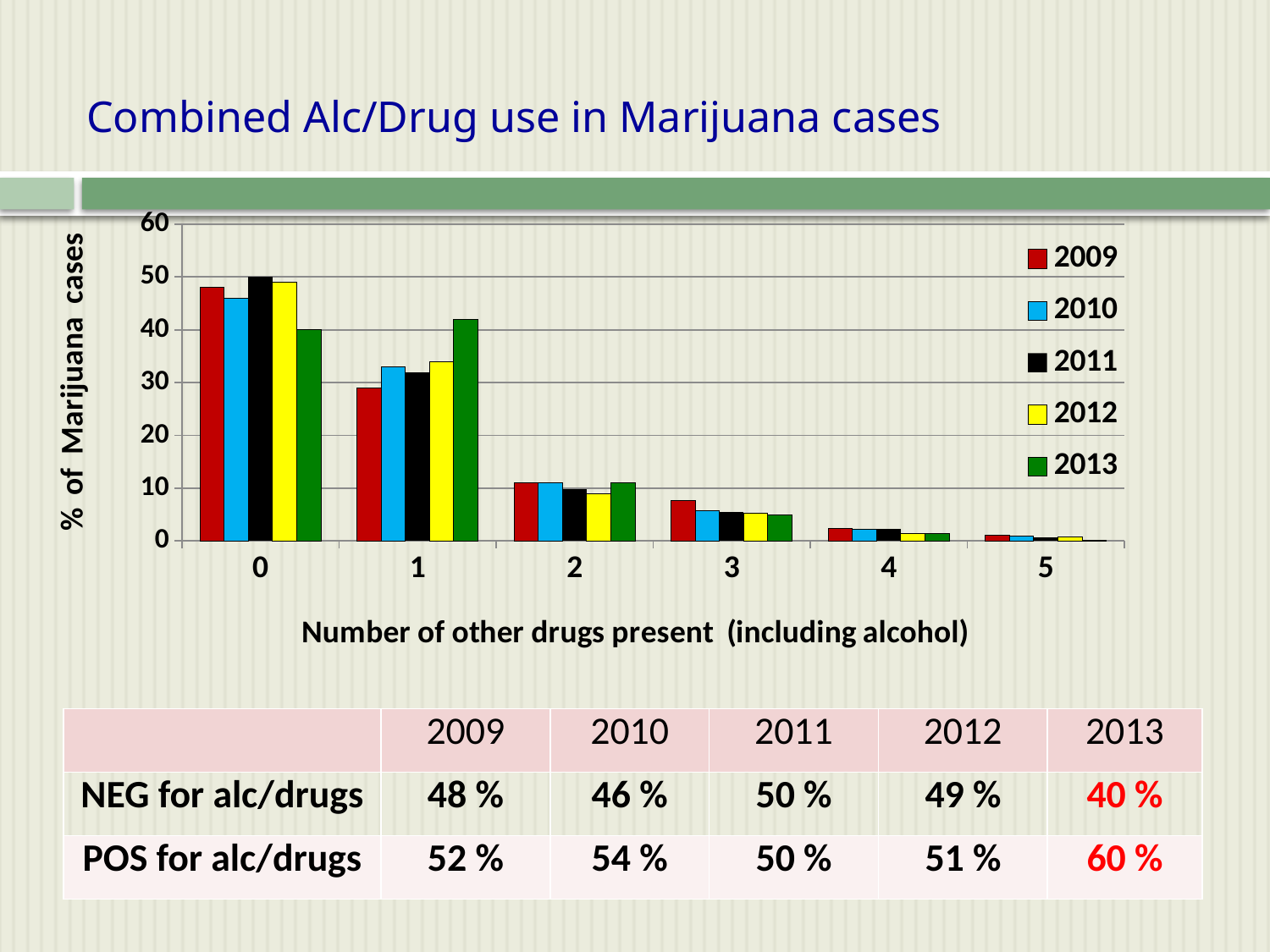
Is the value for 2011 at 4 other drugs present greater or less than 5? less What colour represents the 2013 series in the chart? green Which year has the highest bar for 1 other drug present? 2013 Which year has the lowest bar for 0 other drugs present? 2013 What kind of chart is shown on the slide? bar chart Is the value for 2010 at 1 other drug present greater or less than 30? greater How many series does the chart legend list? 5 Is the value for 2009 at 3 other drugs present greater or less than 10? less Do the values generally rise or fall as the number of other drugs present increases along the x axis? fall For 1 other drug present, which is larger: the 2013 bar or the 2009 bar? 2013 How many categories are shown along the x axis of the chart? 6 Which year has the lowest bar for 1 other drug present? 2009